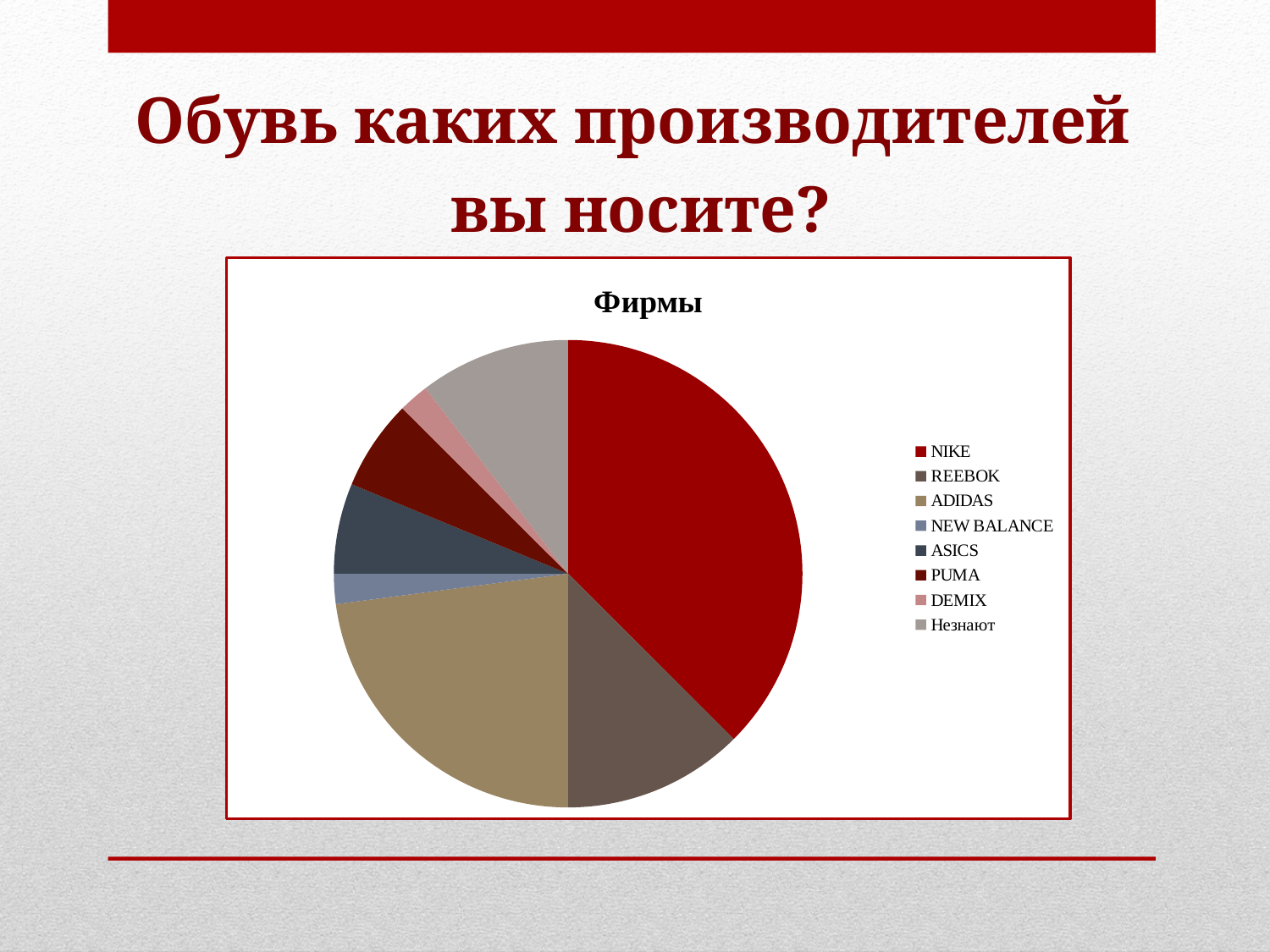
How many categories does the pie chart have? 8 Which is larger, the slice for REEBOK or the slice for ASICS? REEBOK What is the title of the chart? Фирмы Which category has the largest slice of the pie? NIKE How many entries does the legend list? 8 What kind of chart is shown on the slide? pie chart Which is larger, the slice for NIKE or the slice for ADIDAS? NIKE Which is larger, the slice for Незнают or the slice for PUMA? Незнают What colour is the NIKE slice in the pie chart? red